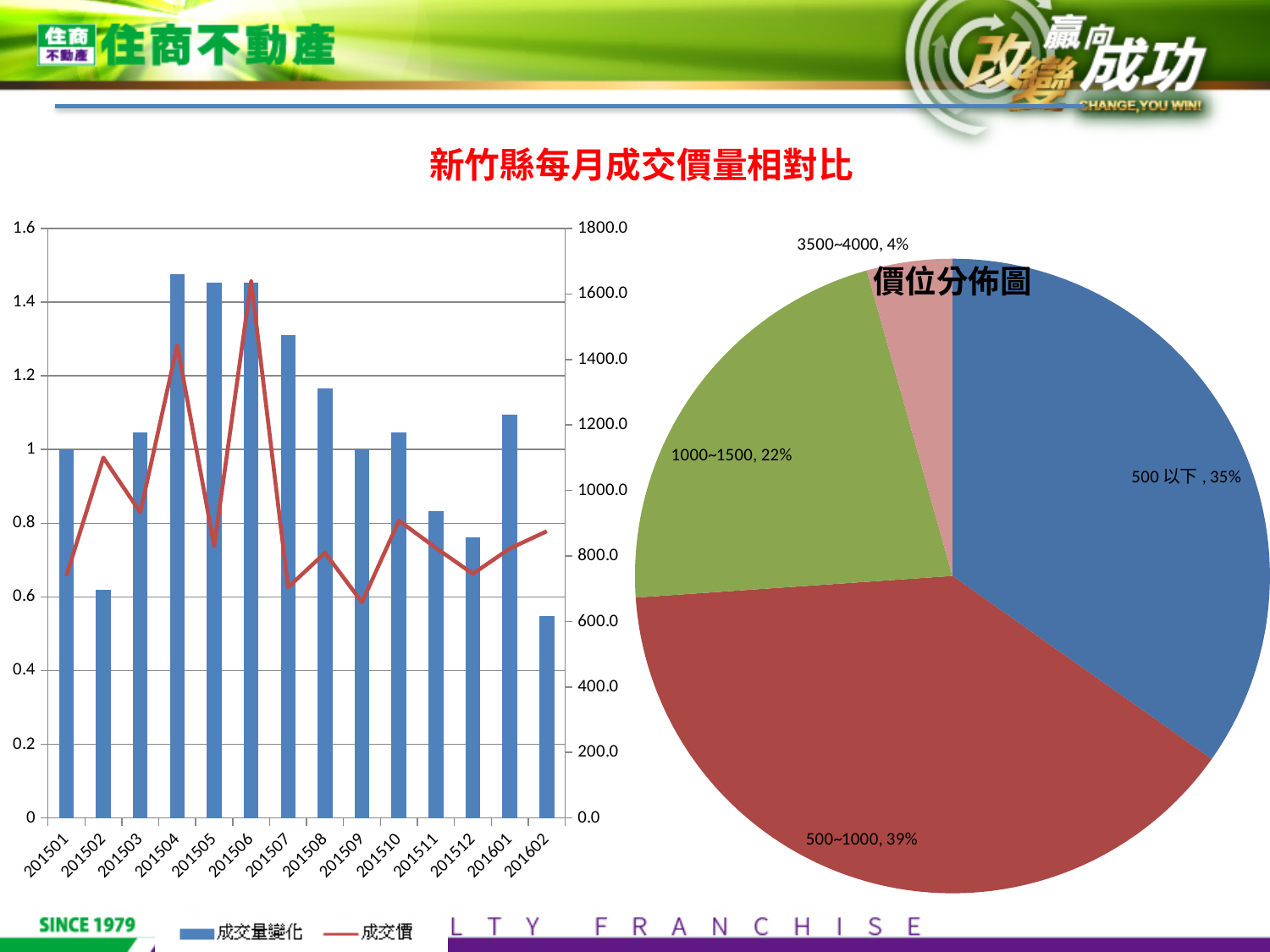
In the pie chart 價位分佈圖, how many slices are there? 4 In the pie chart 價位分佈圖, what share does the 500~1000 slice have? 39% In the left chart, how many months are shown on the x axis? 14 In the pie chart 價位分佈圖, which is larger, the 500 以下 slice or the 500~1000 slice? 500~1000 In the left chart, how many series does the legend list? 2 In the left chart, which month has the lowest 成交量變化 bar? 201602 In the left chart, is the 成交量變化 bar for 201504 greater or less than 1.4? greater In the left chart, which month has the highest 成交價 value on the line? 201506 In the pie chart 價位分佈圖, which category has the largest share? 500~1000 In the pie chart 價位分佈圖, which category has the smallest share? 3500~4000 In the pie chart 價位分佈圖, what share does the 1000~1500 slice have? 22% In the pie chart 價位分佈圖, what is the difference in percentage points between the 500 以下 slice and the 1000~1500 slice? 13